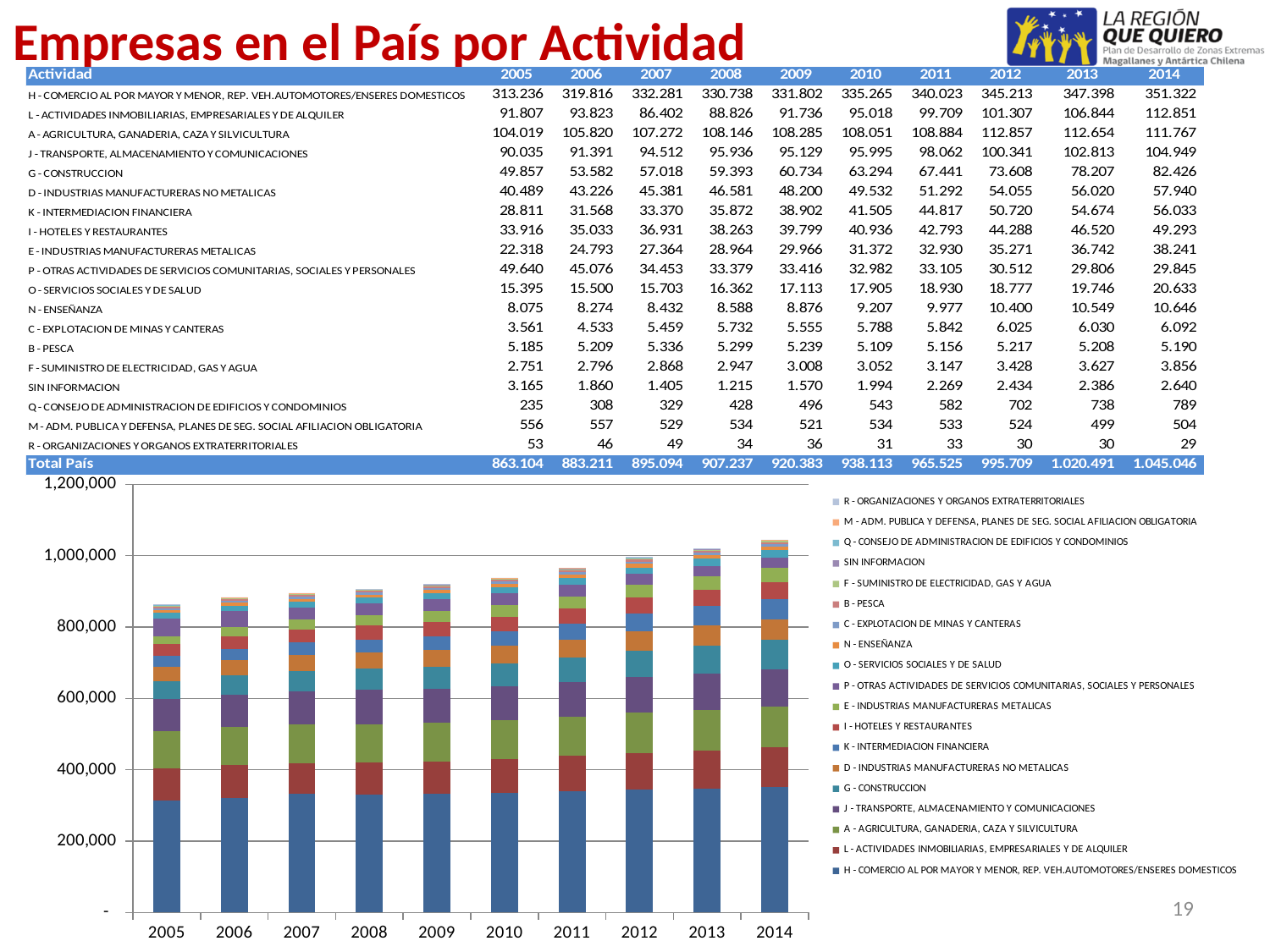
What is the total of the 2005 stacked bar (Total País for 2005)? 863.104 What is the total of the 2014 stacked bar (Total País for 2014)? 1.045.046 Do the total heights of the stacked bars rise or fall from 2005 to 2014? rise Is the total height of the 2014 stacked bar greater or less than 1,000,000? greater Which year has the shortest stacked bar? 2005 Is the total height of the 2005 stacked bar greater or less than 1,000,000? less What kind of chart is shown at the bottom of the slide? bar chart How many years are shown along the x axis of the stacked bar chart? 10 Which year has the tallest stacked bar? 2014 By how much does the Total País for 2014 exceed the Total País for 2005? 181.942 Which series forms the bottom (blue) segment of each stacked bar? H - COMERCIO AL POR MAYOR Y MENOR, REP. VEH.AUTOMOTORES/ENSERES DOMESTICOS How many series does the legend of the stacked bar chart list? 19